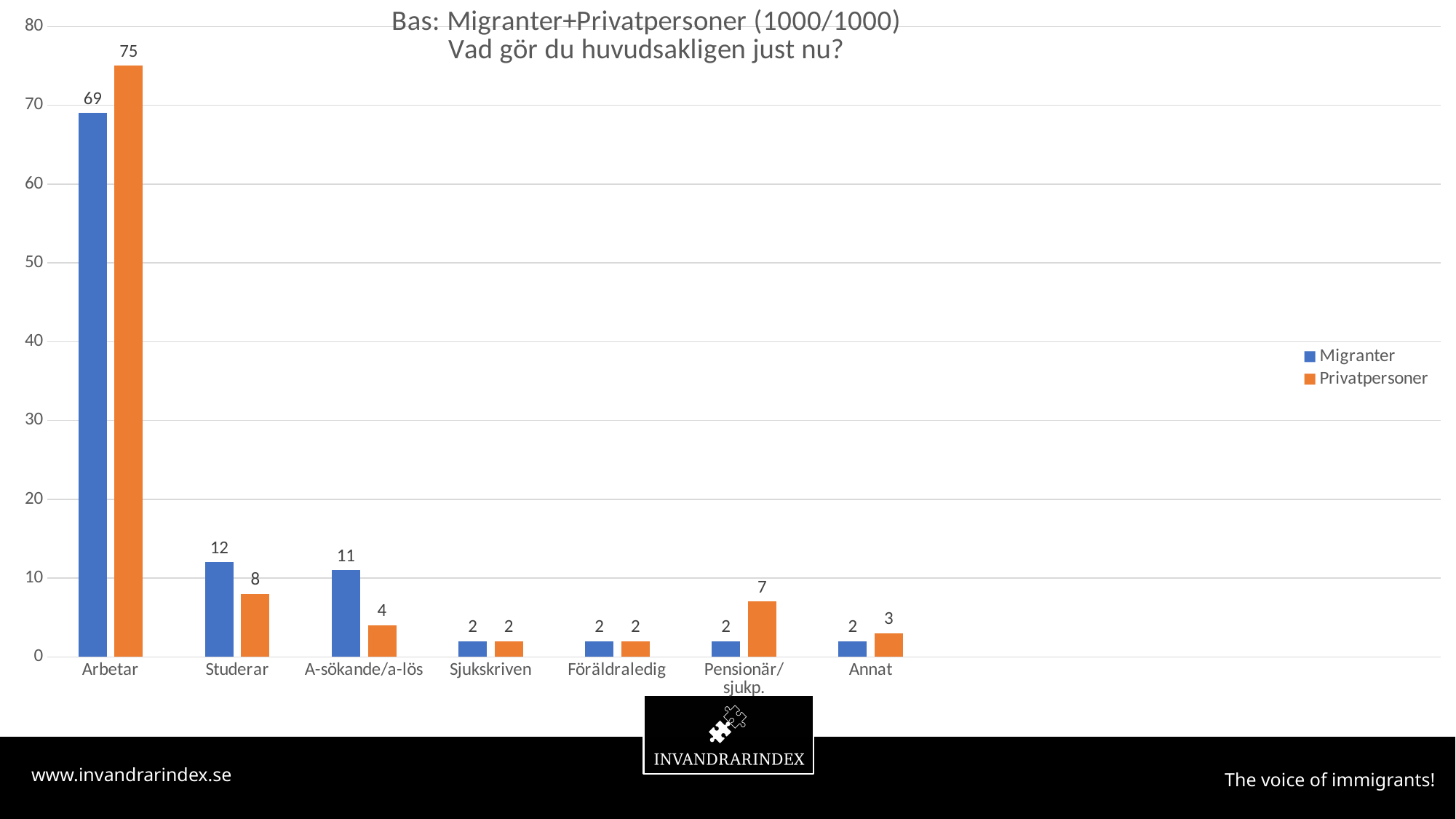
What kind of chart is shown on the slide? Bar chart What is the difference between the Privatpersoner and Migranter values for Arbetar? 6 How many categories are shown on the x axis? 7 Which is larger for Studerar: Migranter or Privatpersoner? Migranter Which category has the lowest value for Privatpersoner? Sjukskriven and Föräldraledig (both 2) What is the value for Migranter in the Arbetar category? 69 What is the difference between the Migranter and Privatpersoner values for A-sökande/a-lös? 7 How many series does the legend list? 2 Which category has the highest value for Privatpersoner? Arbetar What is the value for Privatpersoner in the Pensionär/sjukp. category? 7 What is the value for Privatpersoner in the Studerar category? 8 Is the value for Migranter in Arbetar greater or less than 60? greater